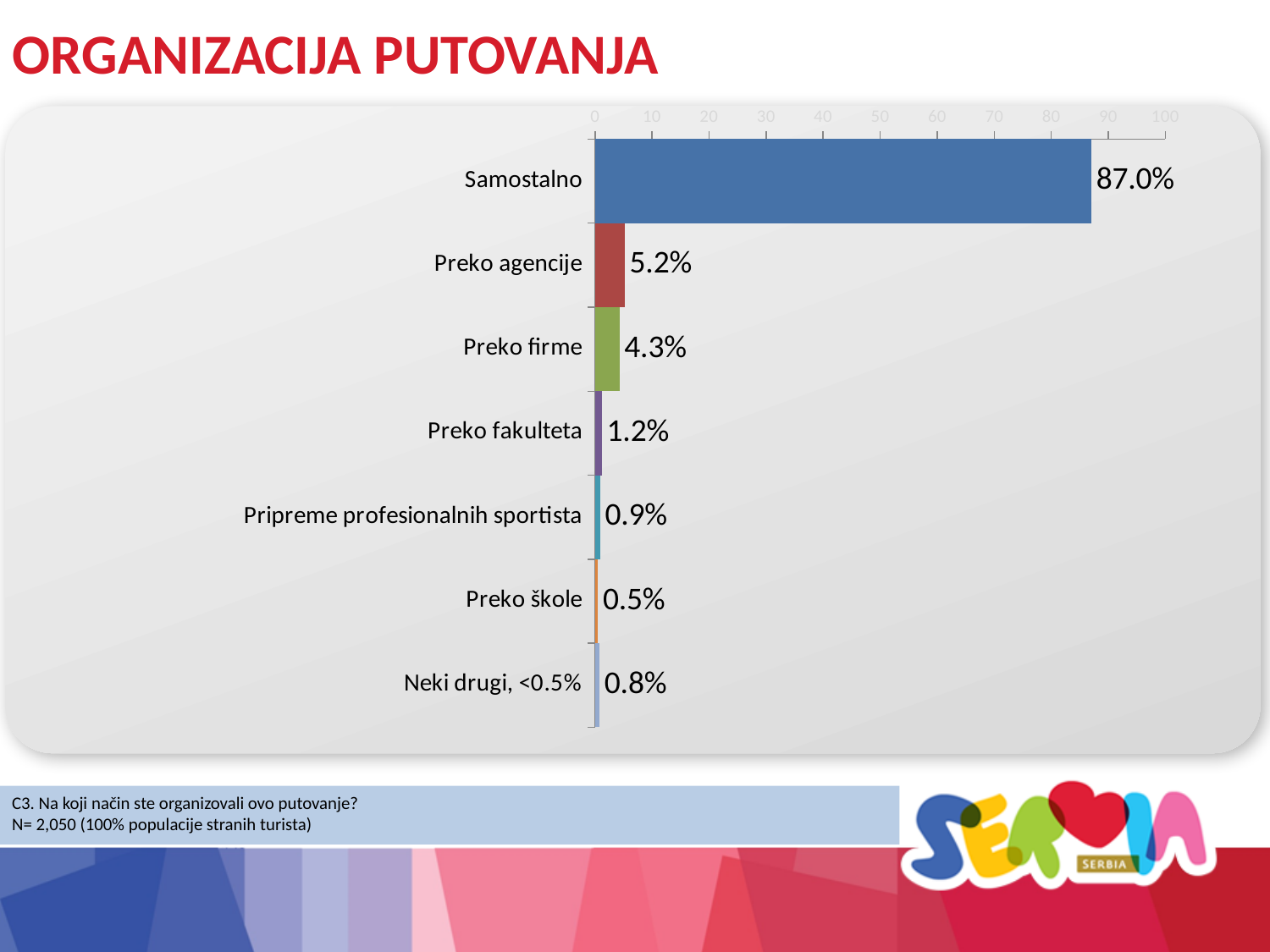
What is the value for Pripreme profesionalnih sportista? 0.9% Which category has the lowest value? Preko škole What is the title of the slide? ORGANIZACIJA PUTOVANJA How many categories are shown in the chart? 7 What kind of chart is shown on the slide? bar chart What is the value for Preko agencije? 5.2% What is the value for Samostalno? 87.0% What is the difference between the values for Preko agencije and Preko firme? 0.9% Which category has the highest value? Samostalno Is the value for Samostalno greater or less than 80? greater Which is larger, the value for Preko firme or the value for Preko fakulteta? Preko firme What is the value for Preko fakulteta? 1.2%